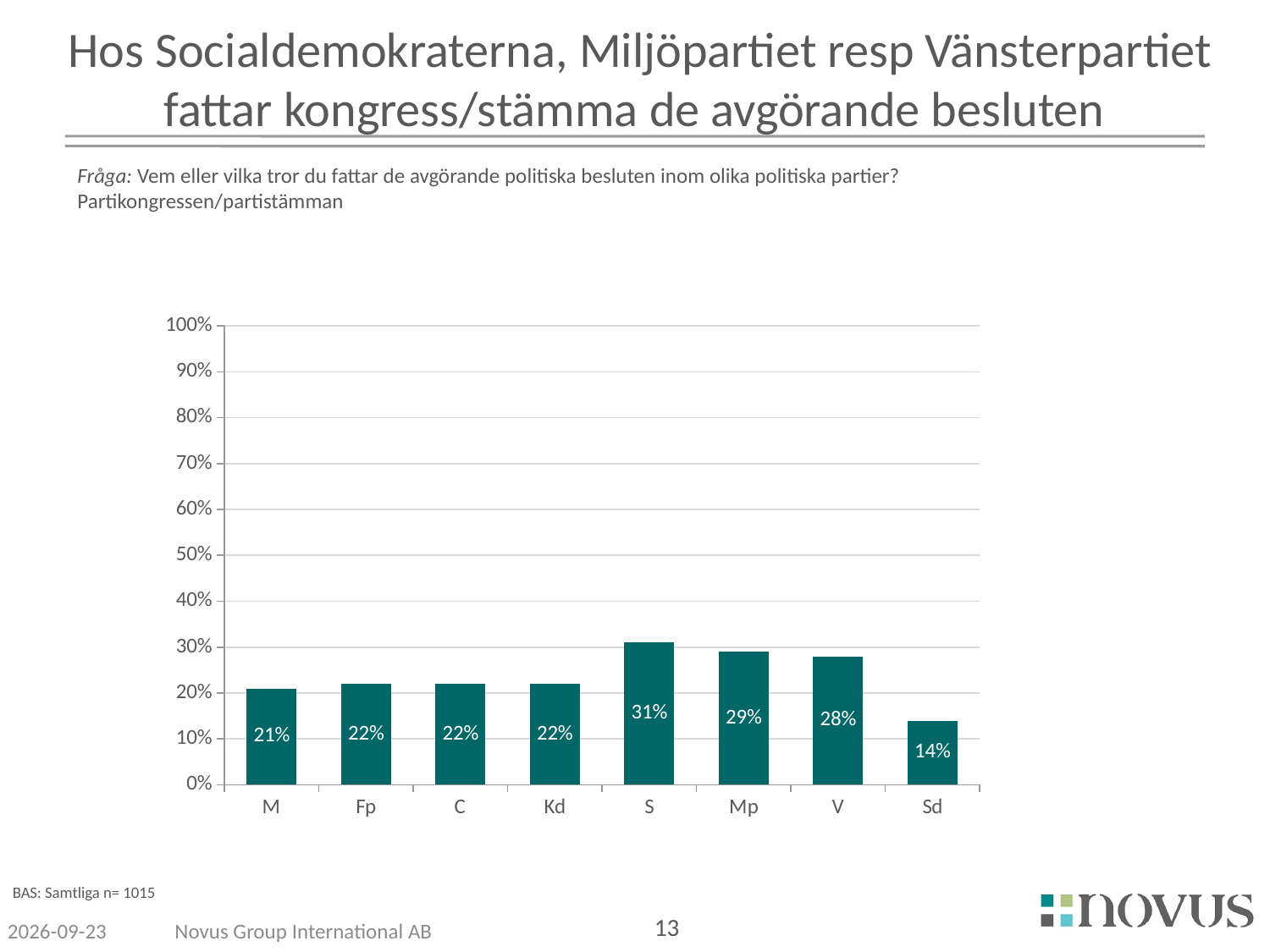
Which party has the lowest value? Sd What is the value for M? 21% What is the value for S? 31% How many parties are shown on the x axis? 8 What is the difference between the values for S and Sd? 17% What is the value for Mp? 29% What kind of chart is shown on the slide? bar chart What is the value for Sd? 14% Which is larger, the value for V or the value for Kd? V Is the value for S greater or less than 40%? less What is the maximum value shown on the y axis? 100% Which party has the highest value? S